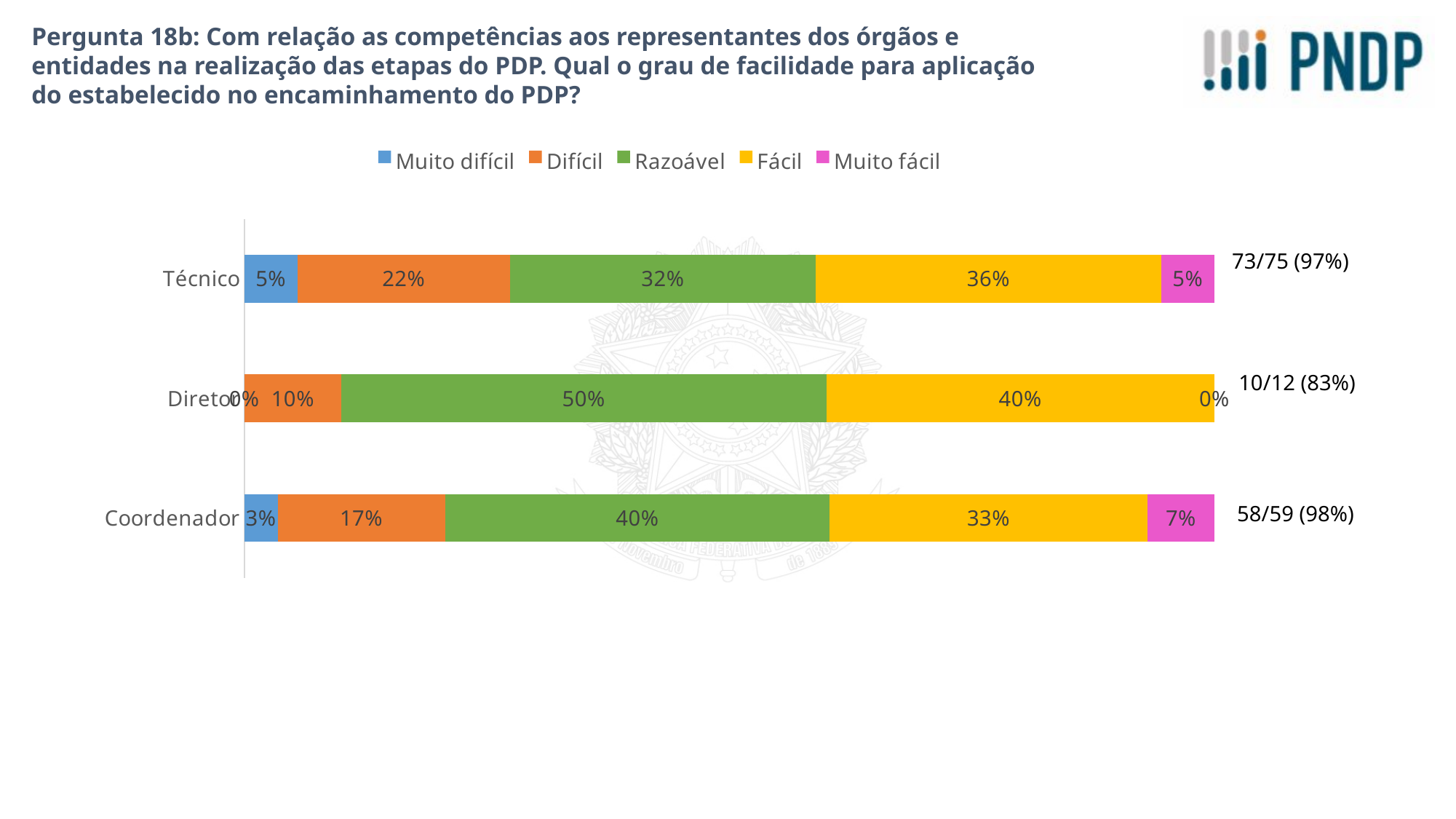
What is the value for Muito fácil in the Coordenador bar? 7% What is the value for Difícil in the Coordenador bar? 17% Which category has the lowest value for Difícil? Diretor What kind of chart is shown? Stacked bar chart What is the difference between the Fácil values for Diretor and Coordenador? 7% What response count and rate is shown next to the Técnico bar? 73/75 (97%) How many series does the legend list? 5 How many categories are shown on the y axis? 3 Which is larger, the Difícil value for Técnico or for Coordenador? Técnico What is the value for Razoável in the Diretor bar? 50% Which category has the highest value for Razoável? Diretor What is the value for Fácil in the Técnico bar? 36%